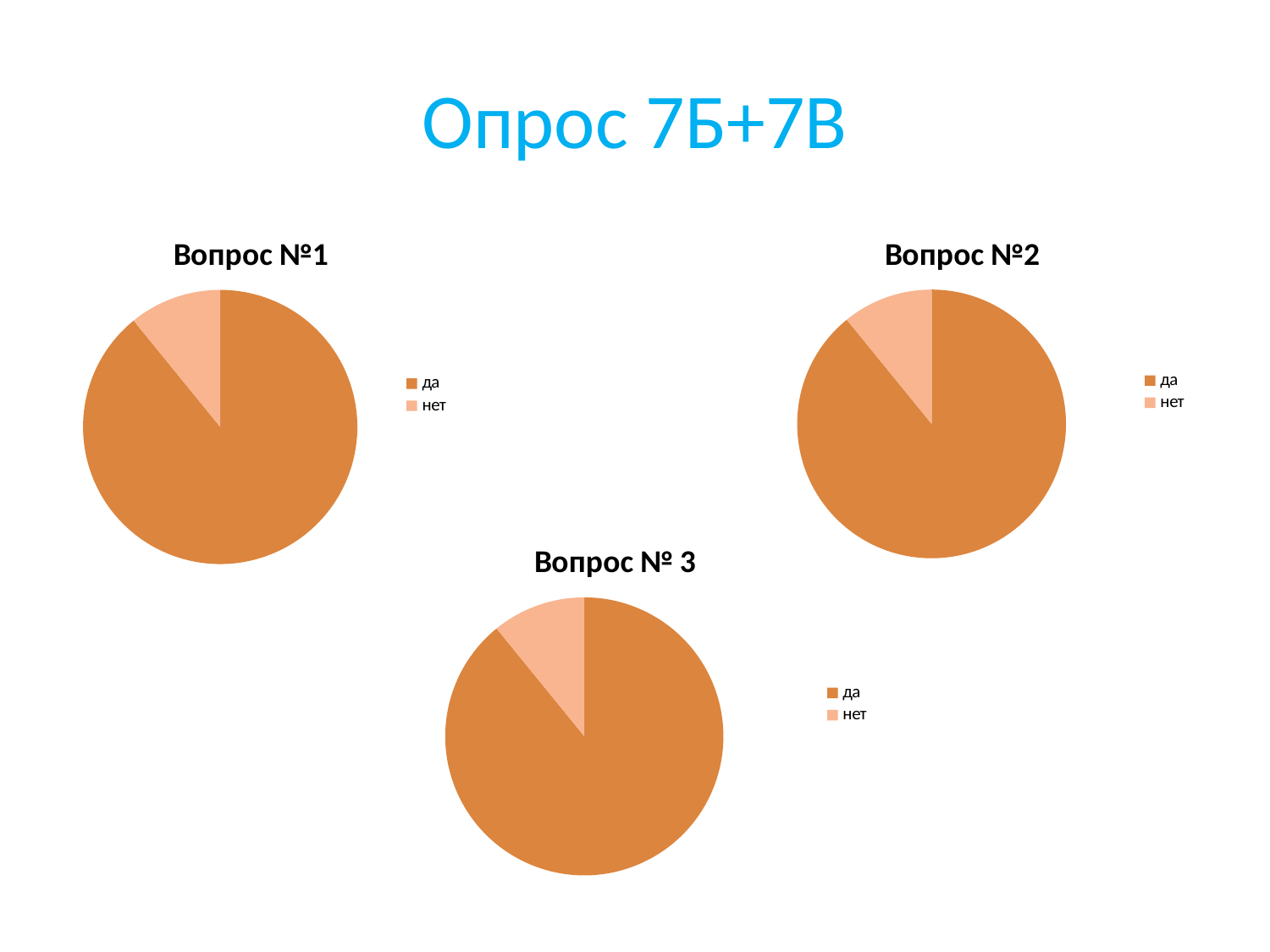
In the "Вопрос №1" chart, which category has the largest slice? да In the "Вопрос №1" chart, which category has the smallest slice? нет In the "Вопрос №2" chart, which category has the smallest slice? нет In the "Вопрос № 3" chart, which slice is smaller, "да" or "нет"? нет What is the title of the chart at the bottom centre of the slide? Вопрос № 3 What kind of chart is "Вопрос № 3"? pie chart How many slices does the "Вопрос №1" pie chart have? 2 What kind of chart is "Вопрос №1"? pie chart In the "Вопрос №2" chart, which slice is larger, "да" or "нет"? да In the "Вопрос № 3" chart, which category has the largest slice? да How many entries does the legend of the "Вопрос №2" chart list? 2 How many pie charts are shown on the slide? 3